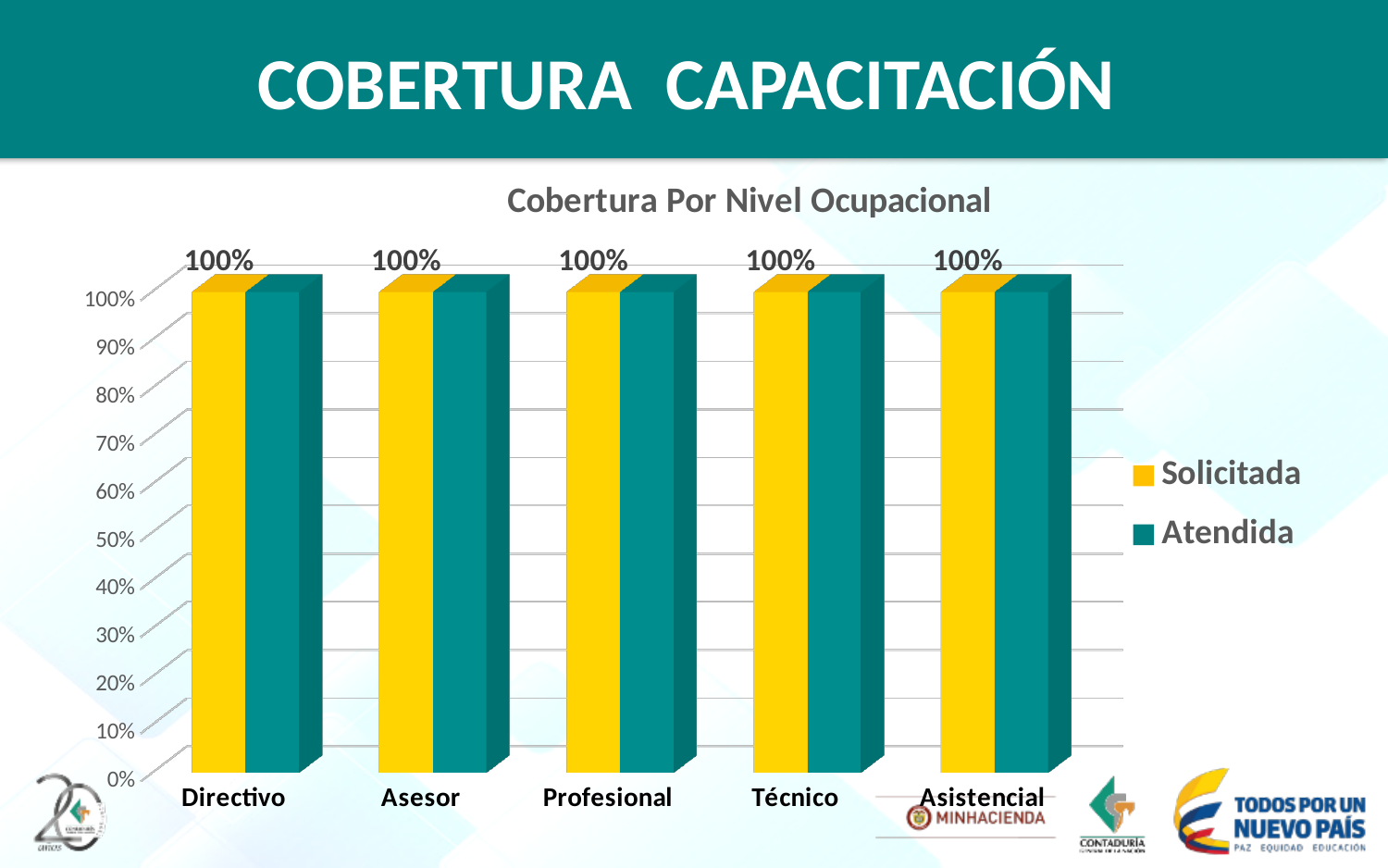
What data label is printed above the bars for Asistencial? 100% What data label is printed above the bars for Técnico? 100% What kind of chart is shown on the slide? bar chart What data label is printed above the bars for Profesional? 100% How many occupational level categories are shown on the x axis? 5 Is the Atendida value for Asesor greater or less than 90%? greater What data label is printed above the bars for Directivo? 100% What data label is printed above the bars for Asesor? 100% Do the values rise, fall, or stay flat across the categories from Directivo to Asistencial? stay flat Which colour represents the Solicitada series in the legend? yellow What is the title of the chart? Cobertura Por Nivel Ocupacional How many series does the legend list? 2